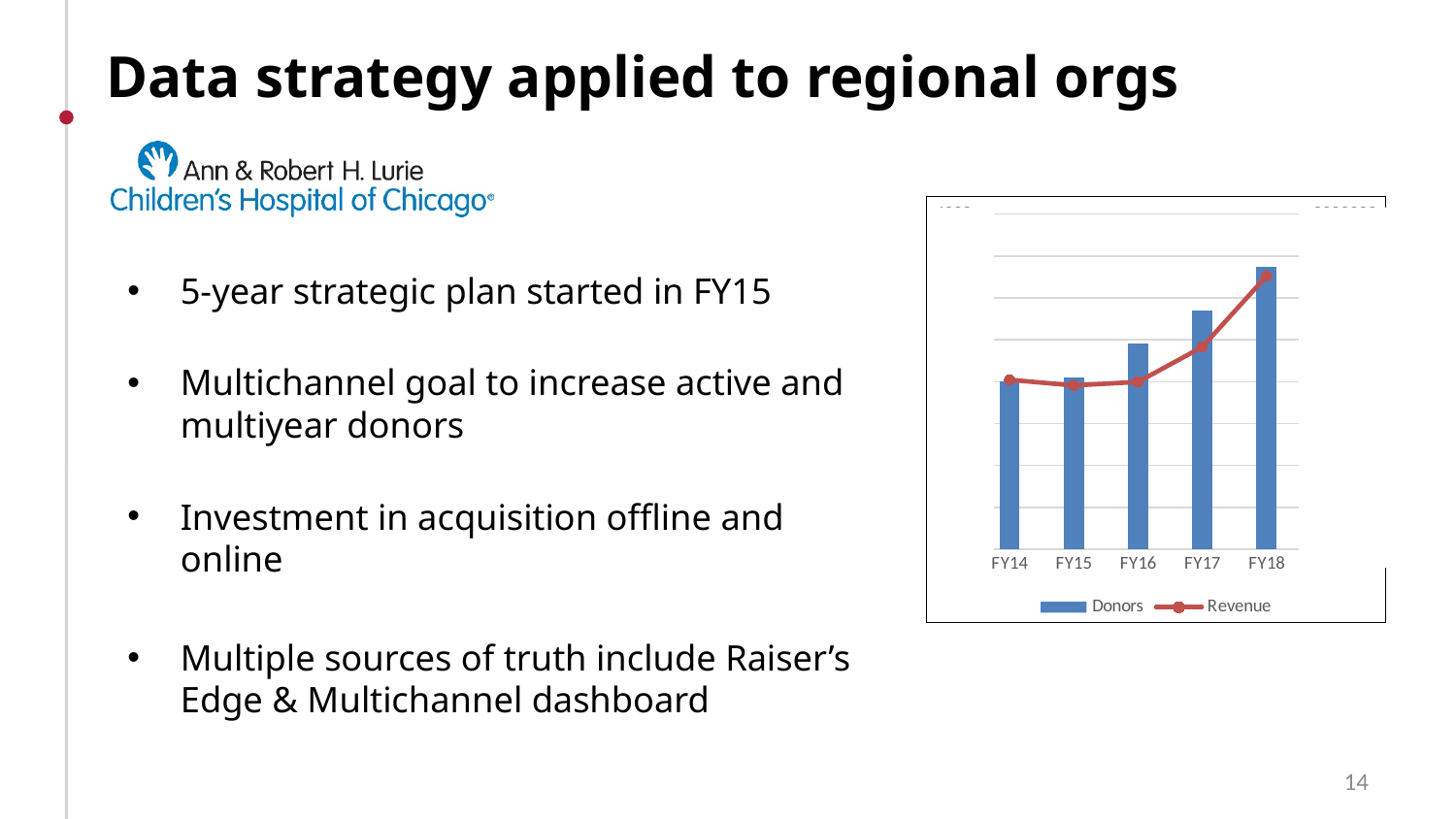
Do the Donors bars generally rise or fall from FY14 to FY18? Rise What is the first fiscal year shown on the x axis of the chart? FY14 Which is larger, the Donors bar for FY17 or the Donors bar for FY15? FY17 In which fiscal year does the Revenue line reach its highest point? FY18 Which fiscal year has the highest Donors bar? FY18 How many series does the chart's legend list? 2 Which series is plotted as bars in the chart? Donors Does the Revenue line rise or fall from FY16 to FY18? Rise Which series is plotted as a line with markers in the chart? Revenue What kind of chart is shown on the slide? A combined bar and line chart How many fiscal years are shown on the x axis of the chart? 5 Which is larger, the Donors bar for FY18 or the Donors bar for FY16? FY18